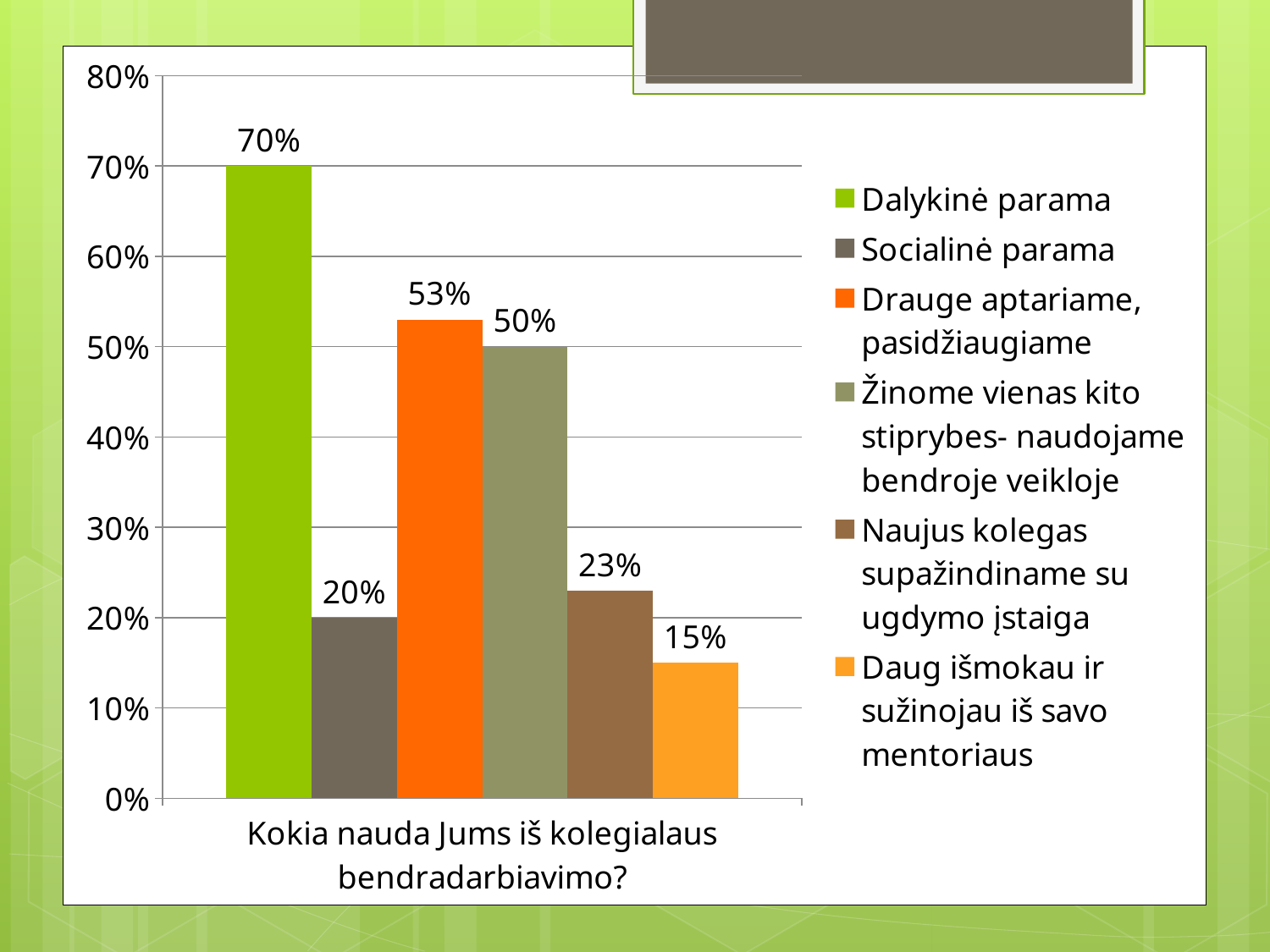
What is the category label shown below the bars? Kokia nauda Jums iš kolegialaus bendradarbiavimo? What is the value for Daug išmokau ir sužinojau iš savo mentoriaus? 15% What colour is the bar for Drauge aptariame, pasidžiaugiame? Orange What is the difference between the values for Dalykinė parama and Socialinė parama? 50% What is the value for Socialinė parama? 20% Which is larger, the value for Naujus kolegas supažindiname su ugdymo įstaiga or the value for Socialinė parama? Naujus kolegas supažindiname su ugdymo įstaiga Which series has the lowest value? Daug išmokau ir sužinojau iš savo mentoriaus How many series does the legend list? 6 What kind of chart is shown on the slide? Bar chart Which series has the highest value? Dalykinė parama What is the value for Dalykinė parama? 70% What is the value for Drauge aptariame, pasidžiaugiame? 53%